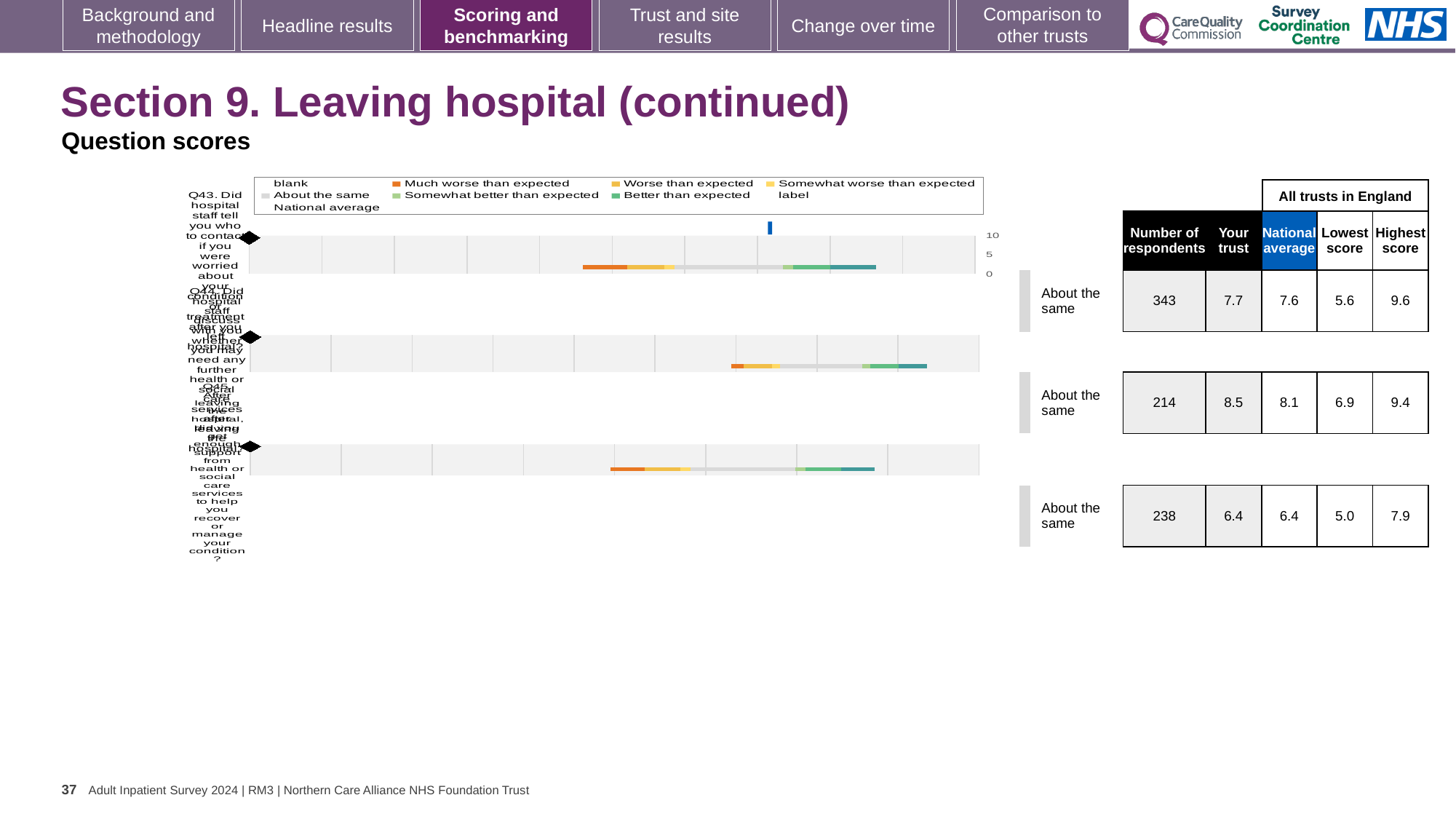
In the table, what is the 'Your trust' score for the second question (Q44)? 8.5 What kind of chart is used for the question scores on this slide? bar chart How many question-score charts are shown on the slide? 3 In the table, what is the number of respondents for the first question (Q43)? 343 In the table, what is the highest score across all trusts in England for the first question (Q43)? 9.6 Which legend entry is shown in dark orange in the chart legend? Much worse than expected What is the highest value shown on the axis of the top chart (Q43)? 10 What rating label is shown beside each of the three charts? About the same In the table, is the 'Your trust' score for the first question (Q43) larger or smaller than the national average? larger In the table, which of the three questions has the lowest 'Your trust' score? Q45 (6.4) In the table, what is the difference between the 'Your trust' score and the national average for the second question (Q44)? 0.4 In the table, what is the national average for the third question (Q45)? 6.4